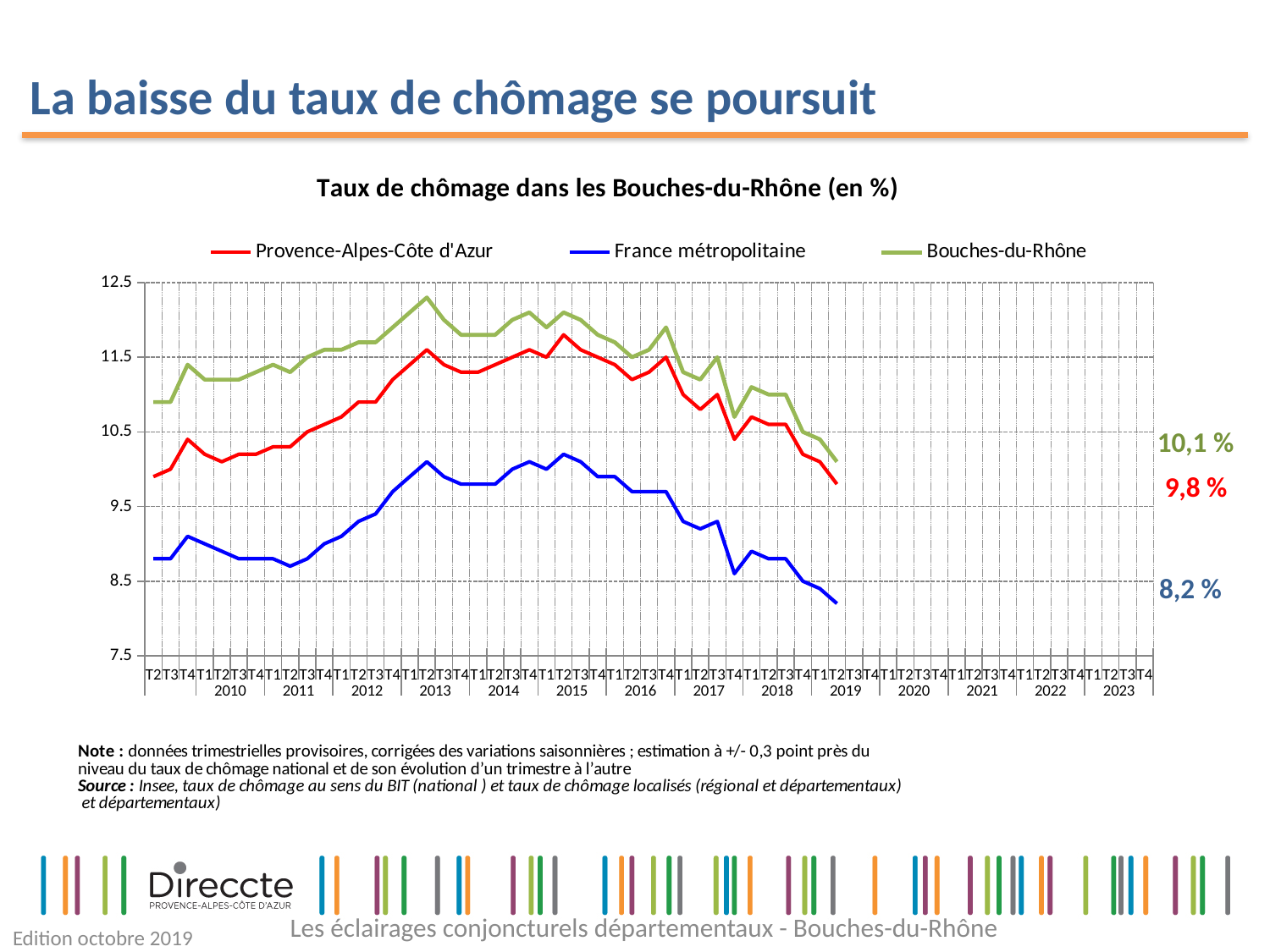
Which series has the highest values across the chart? Bouches-du-Rhône At the end of the series, which is larger: the rate for Provence-Alpes-Côte d'Azur or for France métropolitaine? Provence-Alpes-Côte d'Azur Is the peak value of the Bouches-du-Rhône line in 2013 greater or less than 12.5? less What is the latest labelled unemployment rate for France métropolitaine? 8,2 % What is the latest labelled unemployment rate for Provence-Alpes-Côte d'Azur? 9,8 % How many series does the legend list? 3 Which series has the lowest values across the chart? France métropolitaine What is the latest labelled unemployment rate for Bouches-du-Rhône? 10,1 % Do the unemployment rates rise or fall between 2015 and 2019? Fall Is the peak value of the France métropolitaine line in 2015 greater or less than 10.5? less What is the difference between the latest labelled rates for Bouches-du-Rhône and France métropolitaine? 1,9 points What kind of chart is shown on the slide? Line chart